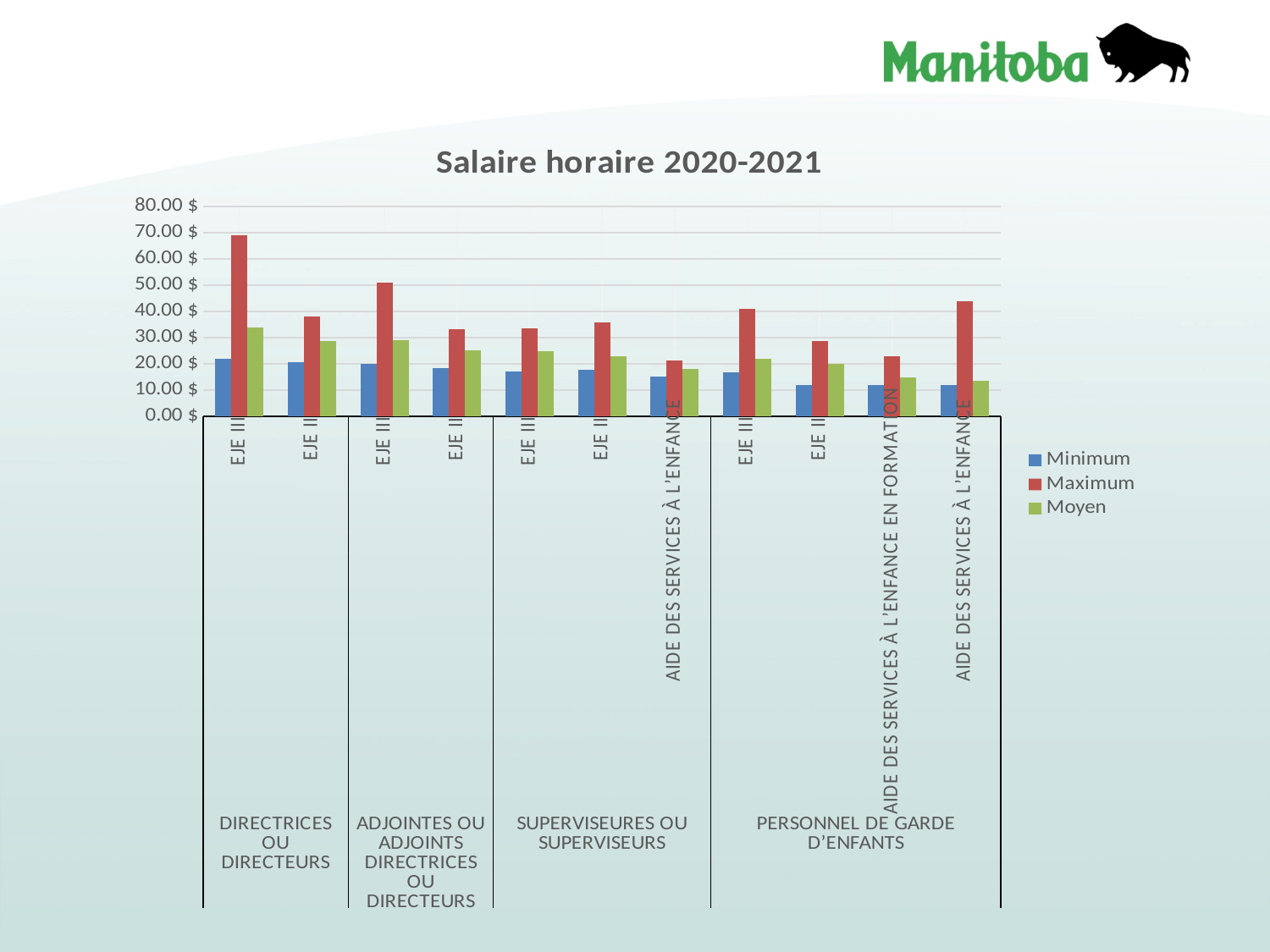
Is the Moyen value for EJE III under Directrices ou directeurs greater or less than 30.00 $? greater What is the title of the chart? Salaire horaire 2020-2021 Which category has the highest Maximum value? EJE III (Directrices ou directeurs) What are the three series named in the legend? Minimum, Maximum, Moyen Which is larger: the Maximum value for EJE III under Directrices ou directeurs or the Maximum value for EJE III under Adjointes ou adjoints directrices ou directeurs? EJE III under Directrices ou directeurs Is the Maximum value for Aide des services à l'enfance under Superviseures ou superviseurs greater or less than 30.00 $? less Is the Maximum value for EJE III under Adjointes ou adjoints directrices ou directeurs greater or less than 40.00 $? greater What kind of chart is shown on the slide? Bar chart How many job categories (bar groups) are plotted along the x axis? 11 How many series does the legend list? 3